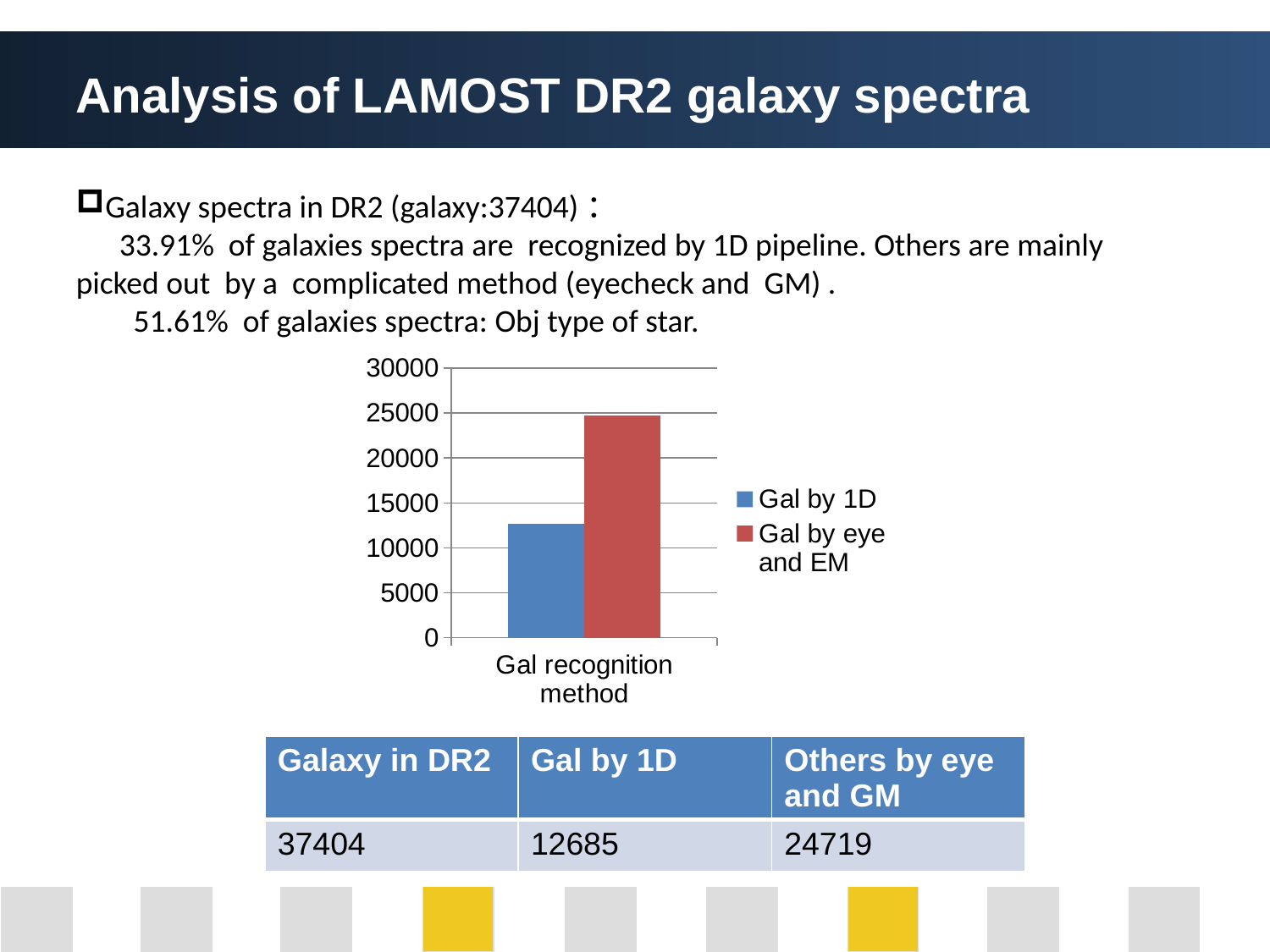
What colour is the bar for Gal by 1D in the chart? blue How many categories are shown on the x axis of the chart? 1 Which series has the higher bar in the chart? Gal by eye and EM How many series does the chart legend list? 2 Is the bar for Gal by 1D greater or less than 10000? greater What is the category label on the x axis of the chart? Gal recognition method What kind of chart is shown on the slide? bar chart Which series has the lower bar in the chart? Gal by 1D Is the bar for Gal by eye and EM greater or less than 20000? greater Which is larger in the chart, Gal by 1D or Gal by eye and EM? Gal by eye and EM Is the bar for Gal by 1D greater or less than 15000? less